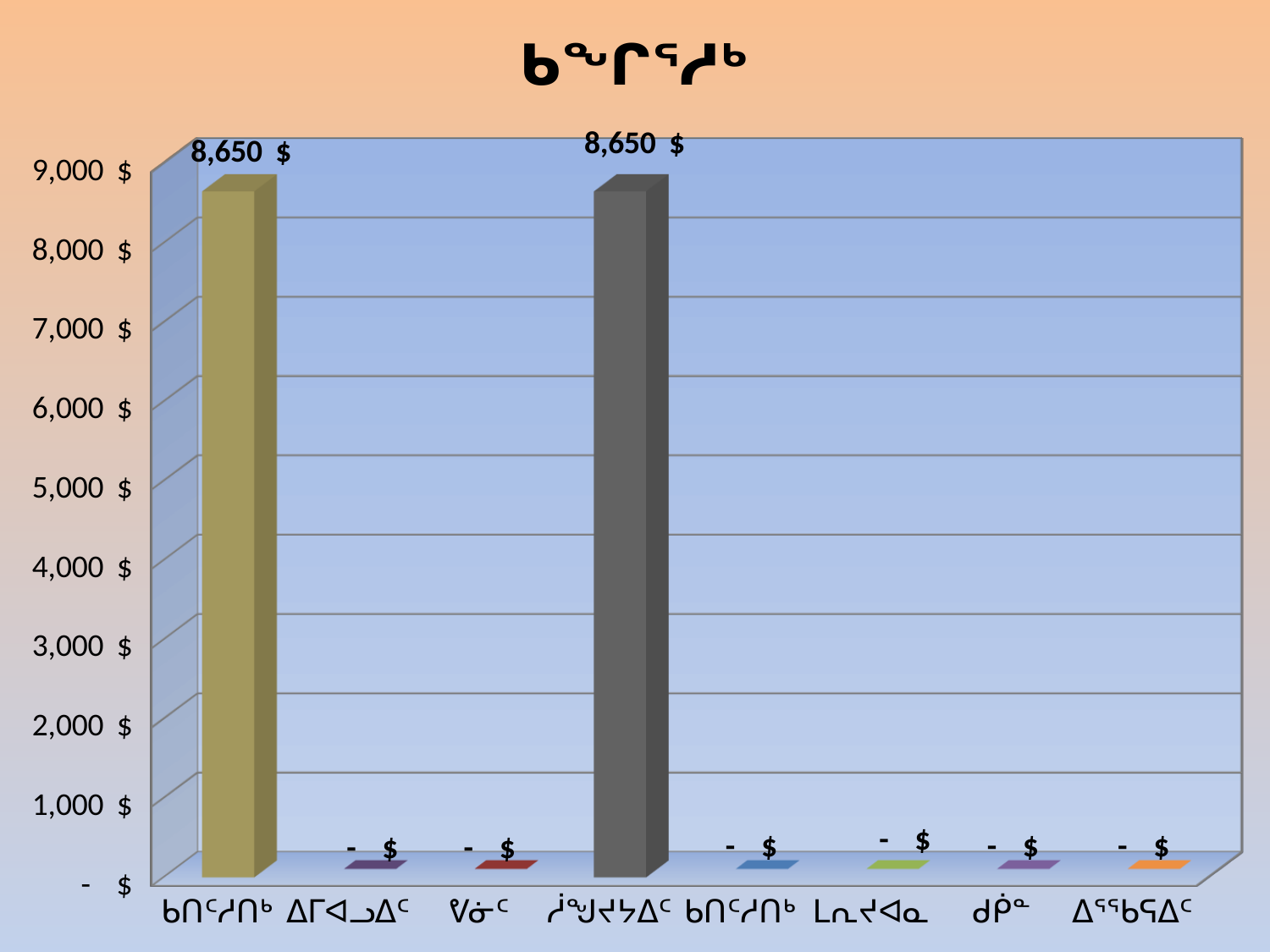
Which is larger: the value of the first bar from the left or the value of the second bar from the left? the first bar What value is labelled above the second bar from the left? - $ What is the value of the first (leftmost) bar in the chart? 8,650 $ What kind of chart is shown on the slide? bar chart How many categories are shown along the x axis of the chart? 8 Is the value of the first bar from the left greater or less than 5,000 $? greater What is the value of the fourth bar from the left in the chart? 8,650 $ How many bars in the chart have a value other than zero (- $)? 2 How many categories share the highest value in the chart? 2 What colour is the fourth bar from the left in the chart? dark grey What is the highest tick value shown on the vertical axis? 9,000 $ What is the difference between the value of the first bar and the value of the fourth bar? 0 $